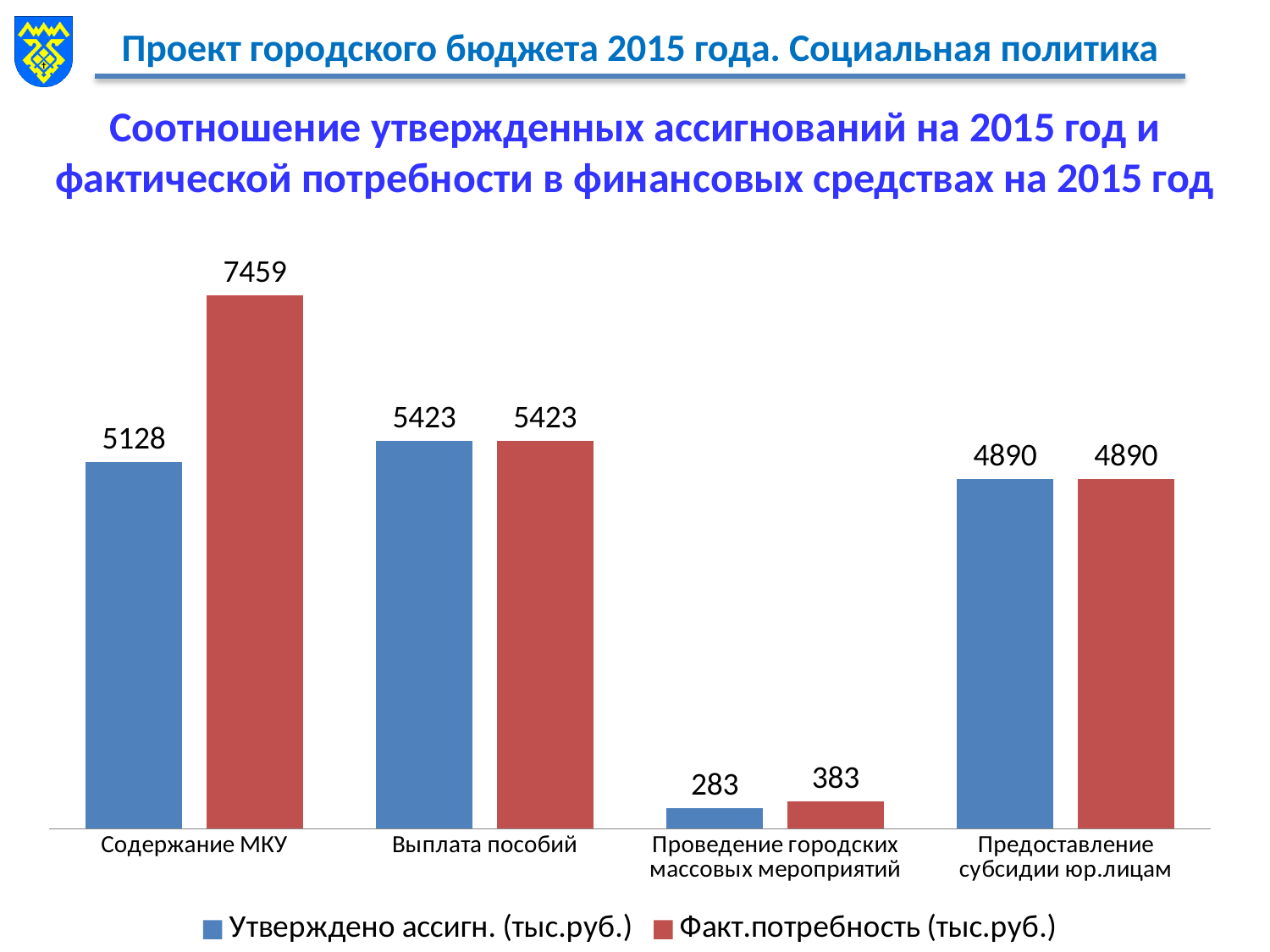
Which is larger for Выплата пособий: Утверждено ассигн. or Факт.потребность? They are equal (5423) What is the value of Утверждено ассигн. (тыс.руб.) for Проведение городских массовых мероприятий? 283 Which category has the lowest Утверждено ассигн. (тыс.руб.) value? Проведение городских массовых мероприятий Which category has the highest Факт.потребность (тыс.руб.) value? Содержание МКУ How many series does the legend list? 2 What kind of chart is shown on the slide? Bar chart What is the difference between Факт.потребность and Утверждено ассигн. for Проведение городских массовых мероприятий? 100 How many categories are shown on the x axis? 4 What is the value of Факт.потребность (тыс.руб.) for Содержание МКУ? 7459 What is the difference between Факт.потребность and Утверждено ассигн. for Содержание МКУ? 2331 What is the value of Факт.потребность (тыс.руб.) for Предоставление субсидии юр.лицам? 4890 What is the value of Утверждено ассигн. (тыс.руб.) for Содержание МКУ? 5128